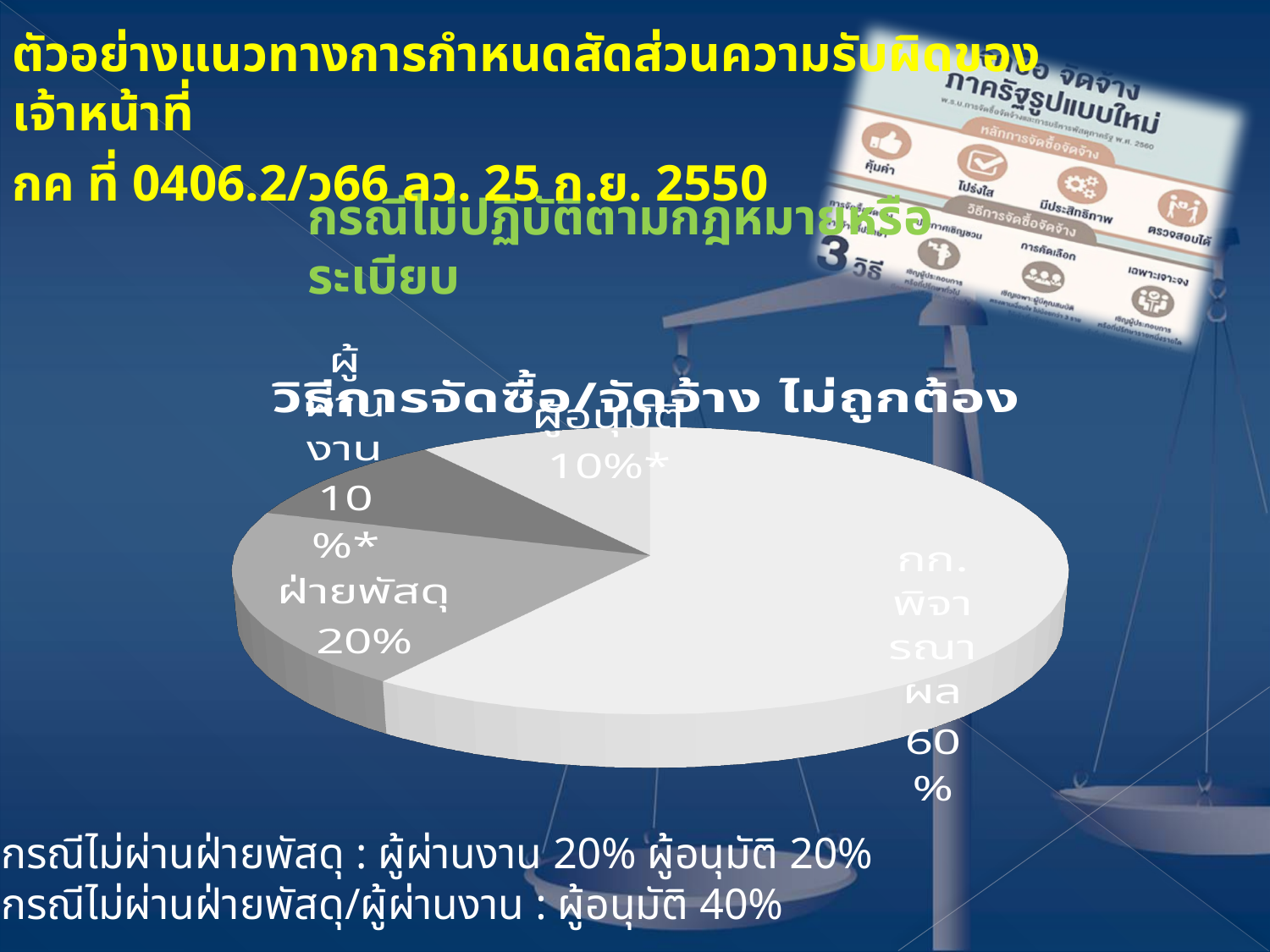
Which is larger, the slice for กก.พิจารณาผล or the slice for ฝ่ายพัสดุ? กก.พิจารณาผล What value is shown for ผู้อนุมัติ? 10%* What share of the pie does กก.พิจารณาผล hold? 60% What value is shown for ผู้ผ่านงาน? 10%* Which category has the largest slice of the pie? กก.พิจารณาผล How many slices does the pie chart have? 4 What share of the pie does ฝ่ายพัสดุ hold? 20% What is the difference between the share for ฝ่ายพัสดุ and the share for ผู้อนุมัติ? 10% What is the title of the pie chart? วิธีการจัดซื้อ/จัดจ้าง ไม่ถูกต้อง What kind of chart is shown on the slide? pie chart Is the share for กก.พิจารณาผล greater or less than 50%? greater What is the difference between the share for กก.พิจารณาผล and the share for ฝ่ายพัสดุ? 40%